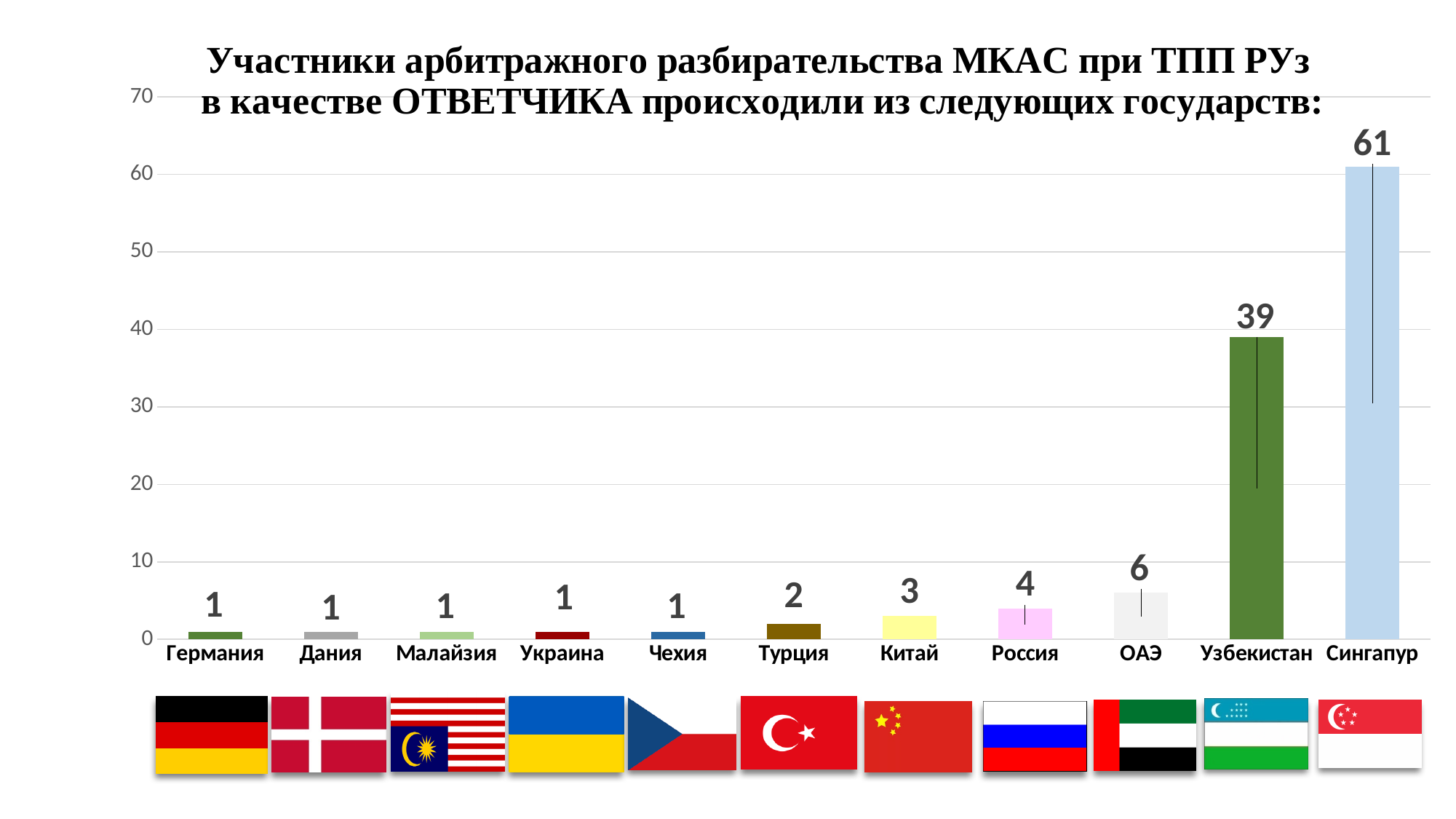
What is the value for Узбекистан? 39 Which is larger, the value for Турция or the value for Россия? Россия What is the difference between the values for Сингапур and Узбекистан? 22 What is the value for Россия? 4 What is the value for Сингапур? 61 Is the value for Узбекистан greater or less than 30? greater What kind of chart is shown on the slide? bar chart What is the value for ОАЭ? 6 Which country has the highest value? Сингапур What is the total of the values for Германия, Дания, Малайзия, Украина and Чехия? 5 How many countries are shown on the x axis? 11 What is the value for Китай? 3